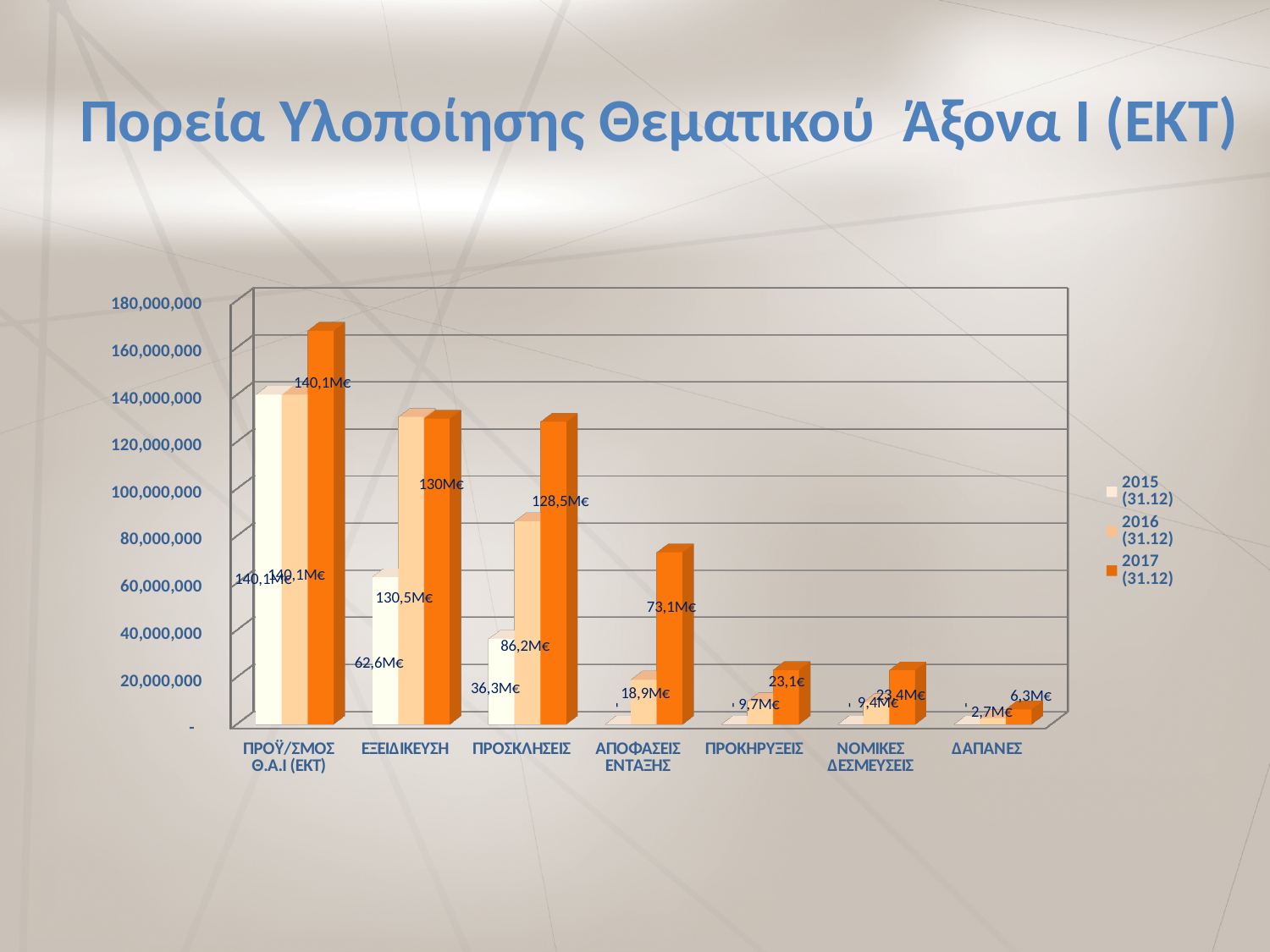
What kind of chart is shown on the slide? Bar chart How many series does the legend list? 3 What is the 2016 (31.12) value for ΔΑΠΑΝΕΣ? 2,7M€ What is the 2017 (31.12) value for ΠΡΟΣΚΛΗΣΕΙΣ? 128,5M€ How many categories are shown on the x axis? 7 What is the 2015 (31.12) value for ΕΞΕΙΔΙΚΕΥΣΗ? 62,6M€ Which is larger for 2017 (31.12): ΠΡΟΣΚΛΗΣΕΙΣ or ΑΠΟΦΑΣΕΙΣ ΕΝΤΑΞΗΣ? ΠΡΟΣΚΛΗΣΕΙΣ Which category has the lowest 2017 (31.12) value? ΔΑΠΑΝΕΣ Is the 2017 (31.12) value for ΠΡΟΫ/ΣΜΟΣ Θ.Α.Ι (ΕΚΤ) greater or less than 160,000,000? greater What is the 2017 (31.12) value for ΑΠΟΦΑΣΕΙΣ ΕΝΤΑΞΗΣ? 73,1M€ Which category has the highest 2017 (31.12) value? ΠΡΟΫ/ΣΜΟΣ Θ.Α.Ι (ΕΚΤ) What is the difference between the 2017 (31.12) and 2016 (31.12) values for ΠΡΟΣΚΛΗΣΕΙΣ? 42,3M€